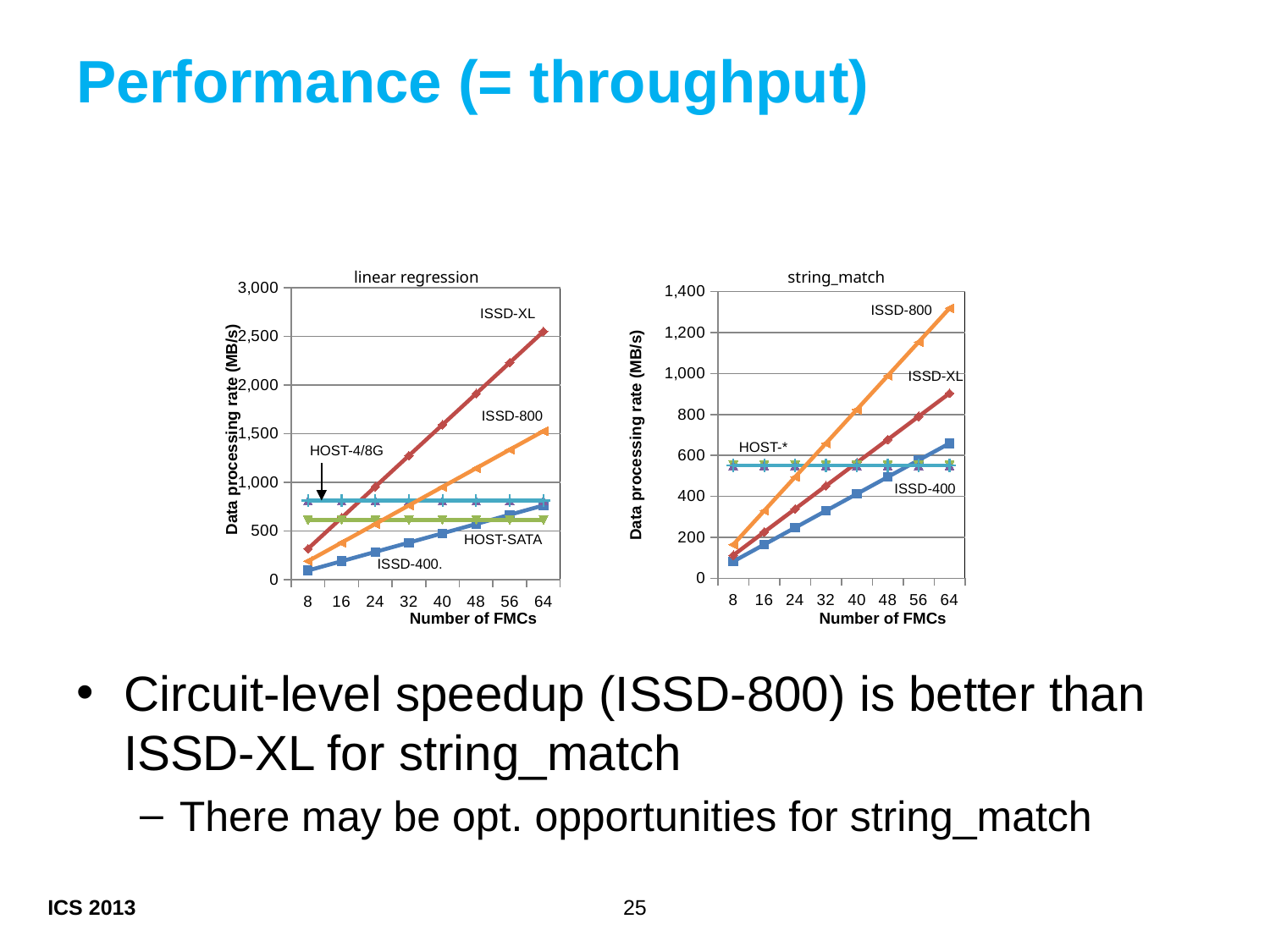
In the string_match chart, which series has the highest data processing rate at 64 FMCs? ISSD-800 In the linear regression chart, at 64 FMCs, which is larger: ISSD-800 or HOST-4/8G? ISSD-800 In the string_match chart, does the HOST-* series rise, fall, or stay flat as the number of FMCs increases? stays flat In the string_match chart, at 64 FMCs, which is larger: ISSD-400 or HOST-*? ISSD-400 In the string_match chart, what is the y-axis label? Data processing rate (MB/s) In the string_match chart, is the value for ISSD-800 at 64 FMCs greater or less than 1,200? greater In the linear regression chart, is the value for ISSD-XL at 64 FMCs greater or less than 2,000? greater In the linear regression chart, is the value for ISSD-400 at 64 FMCs greater or less than 1,000? less In the linear regression chart, what kind of chart is shown? Line chart In the linear regression chart, does the ISSD-800 series rise or fall as the number of FMCs increases? rises In the linear regression chart, how many Number of FMCs values are marked on the x axis? 8 In the linear regression chart, which series has the highest data processing rate at 64 FMCs? ISSD-XL